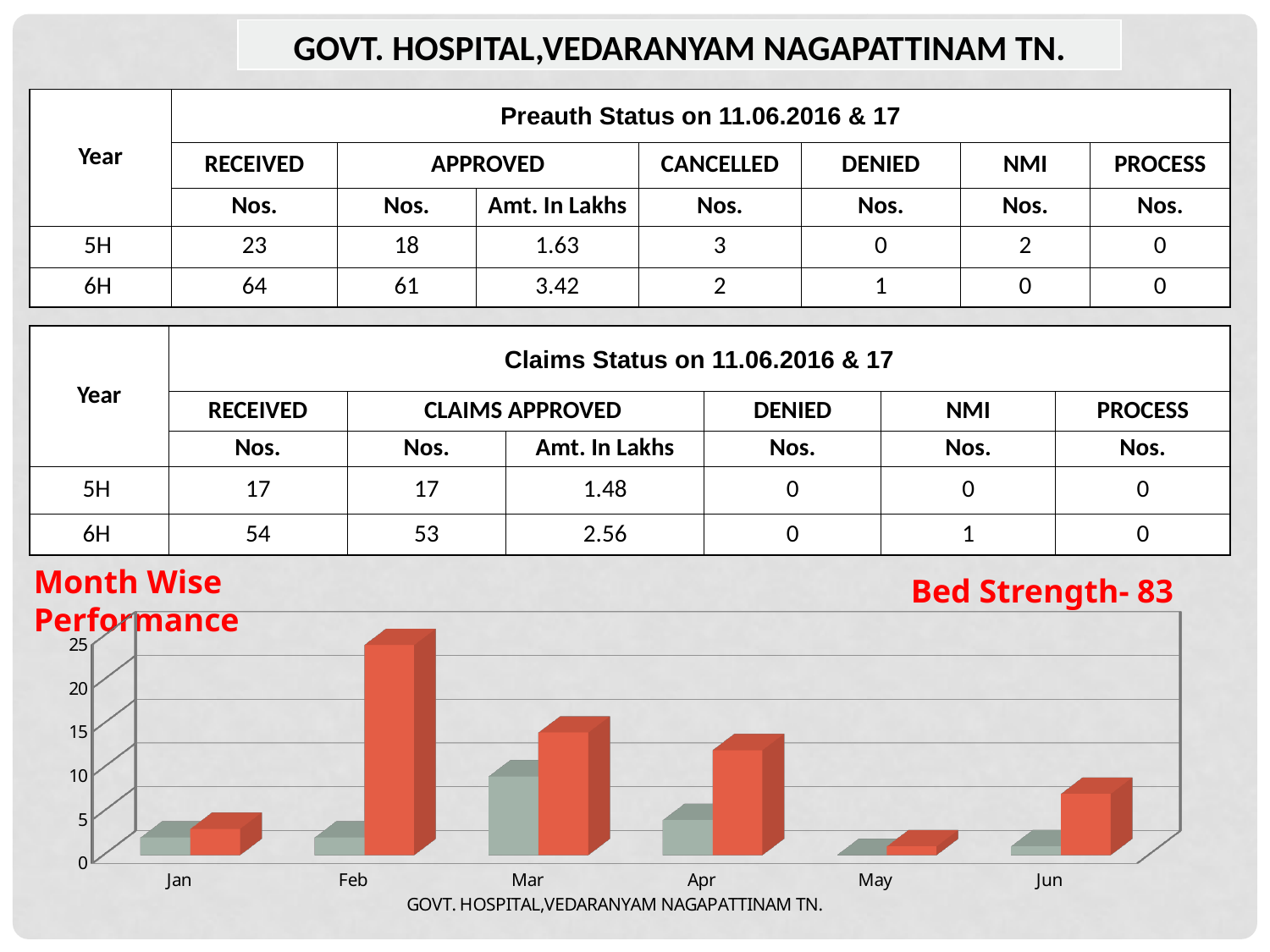
In the Month Wise Performance chart, is the red bar for Feb greater or less than 20? greater In the Month Wise Performance chart, which month has the tallest grey bar? Mar How many months are shown on the x axis of the Month Wise Performance chart? 6 How many data series are plotted for each month in the Month Wise Performance chart? 2 In the Month Wise Performance chart, is the red bar for Jun greater or less than 10? less In the Month Wise Performance chart, which month has the tallest red bar? Feb What kind of chart is the Month Wise Performance chart? bar chart In the Month Wise Performance chart, which is larger: the red bar for Feb or the red bar for Mar? Feb What text appears below the x axis of the Month Wise Performance chart? GOVT. HOSPITAL,VEDARANYAM NAGAPATTINAM TN. In the Month Wise Performance chart, is the red bar for Mar greater or less than 10? greater In the Month Wise Performance chart, which month has the shortest red bar? May